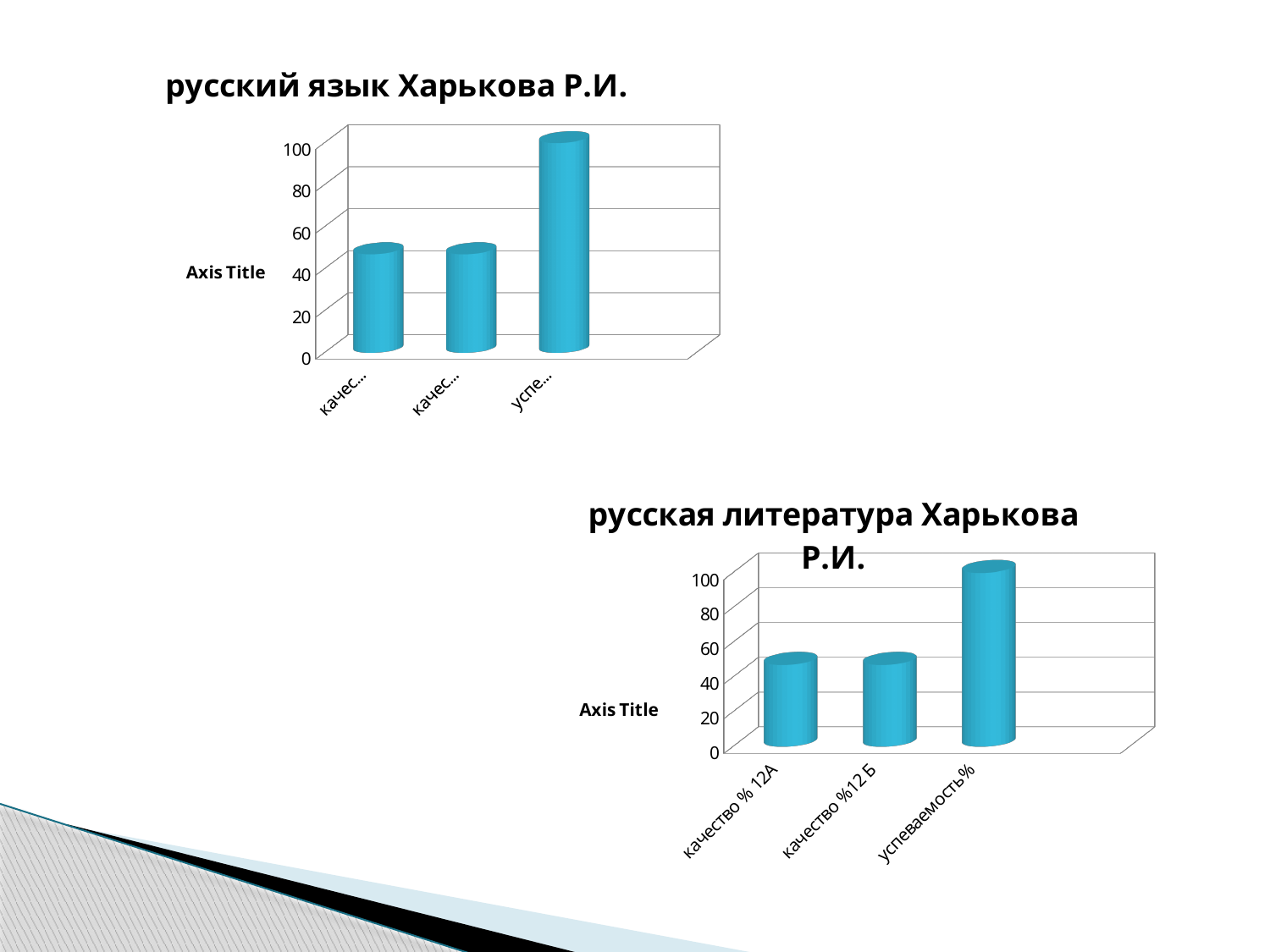
In the chart titled "русская литература Харькова Р.И.", is the value for качество % 12А greater or less than 60? less How many bars are plotted in the chart titled "русская литература Харькова Р.И."? 3 What kind of chart is the chart titled "русская литература Харькова Р.И."? bar chart In the chart titled "русский язык Харькова Р.И.", is the value of the leftmost bar greater or less than 60? less In the chart titled "русская литература Харькова Р.И.", is the value for успеваемость% greater or less than 80? greater In the chart titled "русская литература Харькова Р.И.", which category has the highest value? успеваемость% What is the title of the chart at the top of the slide? русский язык Харькова Р.И. How many bars are plotted in the chart titled "русский язык Харькова Р.И."? 3 What kind of chart is the chart titled "русский язык Харькова Р.И."? bar chart In the chart titled "русская литература Харькова Р.И.", which is larger: the value for успеваемость% or the value for качество % 12А? успеваемость%